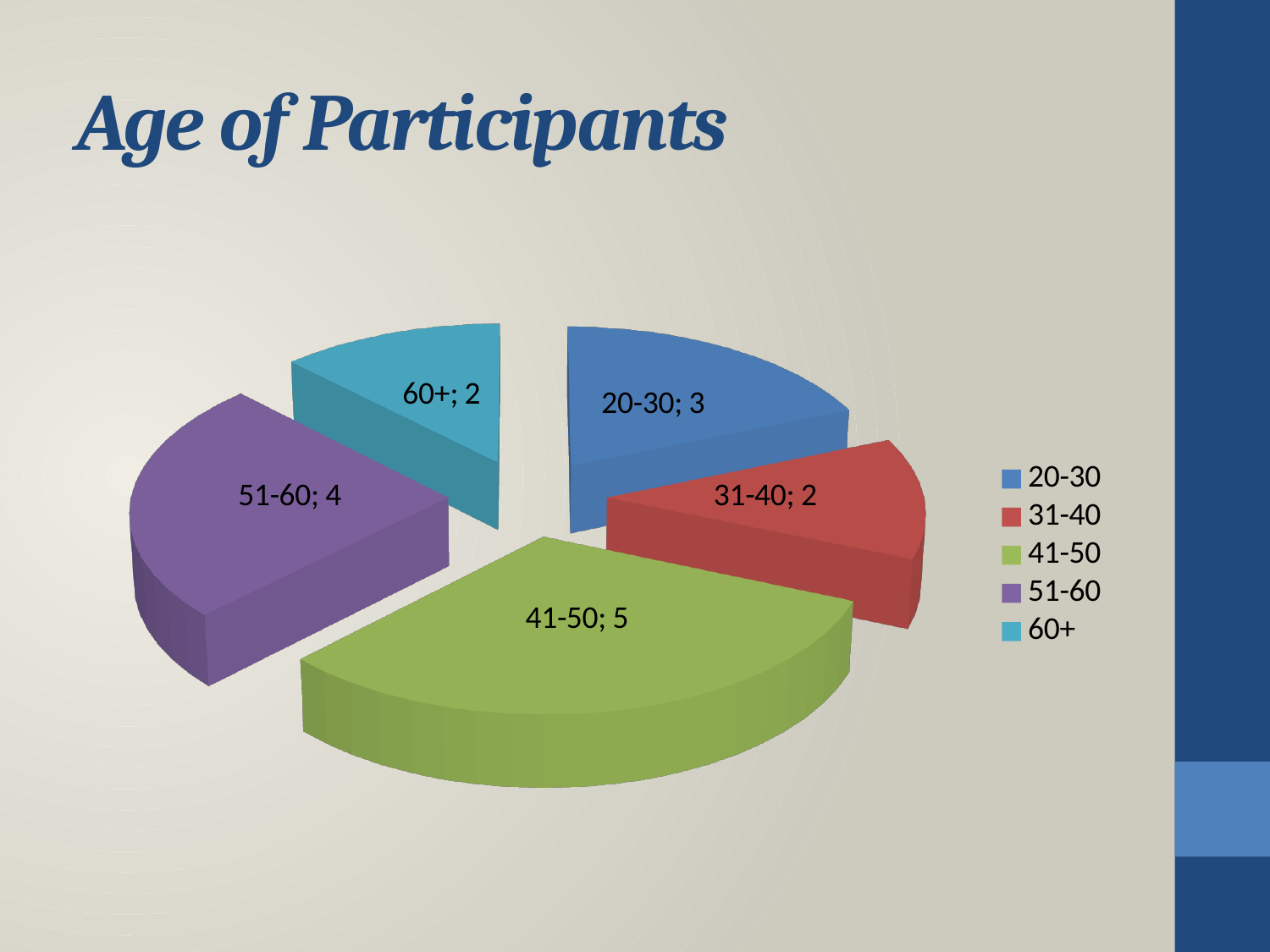
What is the value for the 20-30 age group? 3 What is the total of all the slices in the pie chart? 16 What kind of chart is shown on the slide? Pie chart What share of the pie does the 41-50 slice represent? 5 out of 16 (31.25%) What is the title of the slide? Age of Participants What colour is the 51-60 slice? Purple What is the value for the 51-60 age group? 4 How many age groups are shown in the pie chart? 5 Which is larger, the value for 51-60 or the value for 20-30? 51-60 What is the value for the 41-50 age group? 5 What is the difference between the values for 41-50 and 31-40? 3 Which age group has the highest value? 41-50